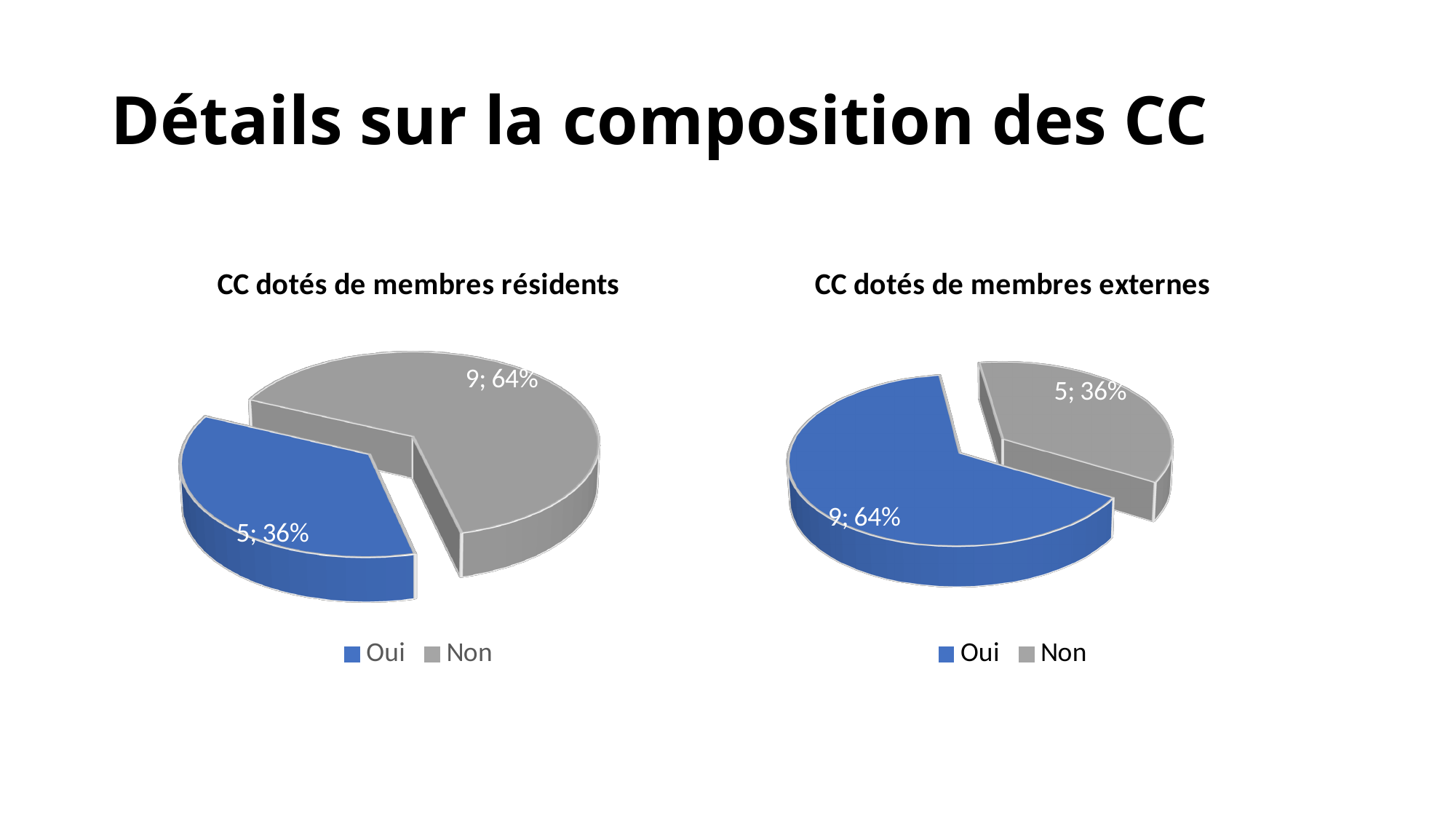
What kind of chart is the chart titled 'CC dotés de membres résidents'? Pie chart In the chart titled 'CC dotés de membres externes', which category has the smallest slice? Non In the chart titled 'CC dotés de membres résidents', what is the value for Oui? 5; 36% In the chart titled 'CC dotés de membres externes', what is the value for Oui? 9; 64% In the chart titled 'CC dotés de membres externes', which is larger, Oui or Non? Oui In the chart titled 'CC dotés de membres résidents', which category has the largest slice? Non In the chart titled 'CC dotés de membres résidents', what is the difference between the count for Non and the count for Oui? 4 In the chart titled 'CC dotés de membres externes', what share of the pie does Oui represent? 64% In the chart titled 'CC dotés de membres externes', what is the value for Non? 5; 36% In the chart titled 'CC dotés de membres résidents', what is the value for Non? 9; 64% In the chart titled 'CC dotés de membres résidents', what share of the pie does Oui represent? 36% How many categories does the legend of the chart titled 'CC dotés de membres externes' list? 2